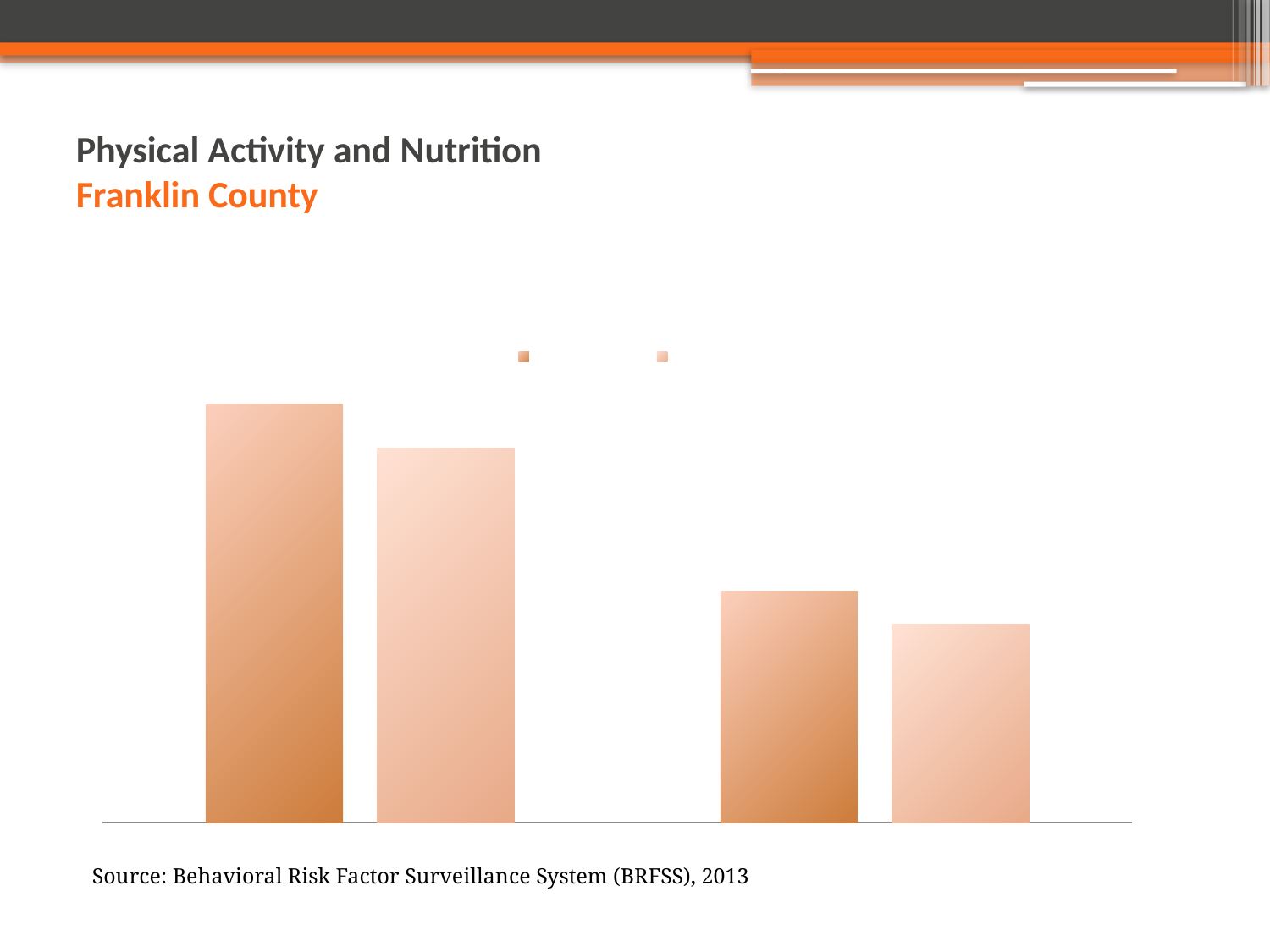
How many groups of bars does the chart show? 2 Which county does the slide title say the chart is about? Franklin County How many series does the legend list? 2 How many bars are plotted in the chart? 4 What data source is cited below the chart? Behavioral Risk Factor Surveillance System (BRFSS), 2013 Which group of bars is taller, the left group or the right group? the left group What kind of chart is shown on the slide? bar chart Within each group, is the darker orange bar taller or shorter than the lighter bar? taller